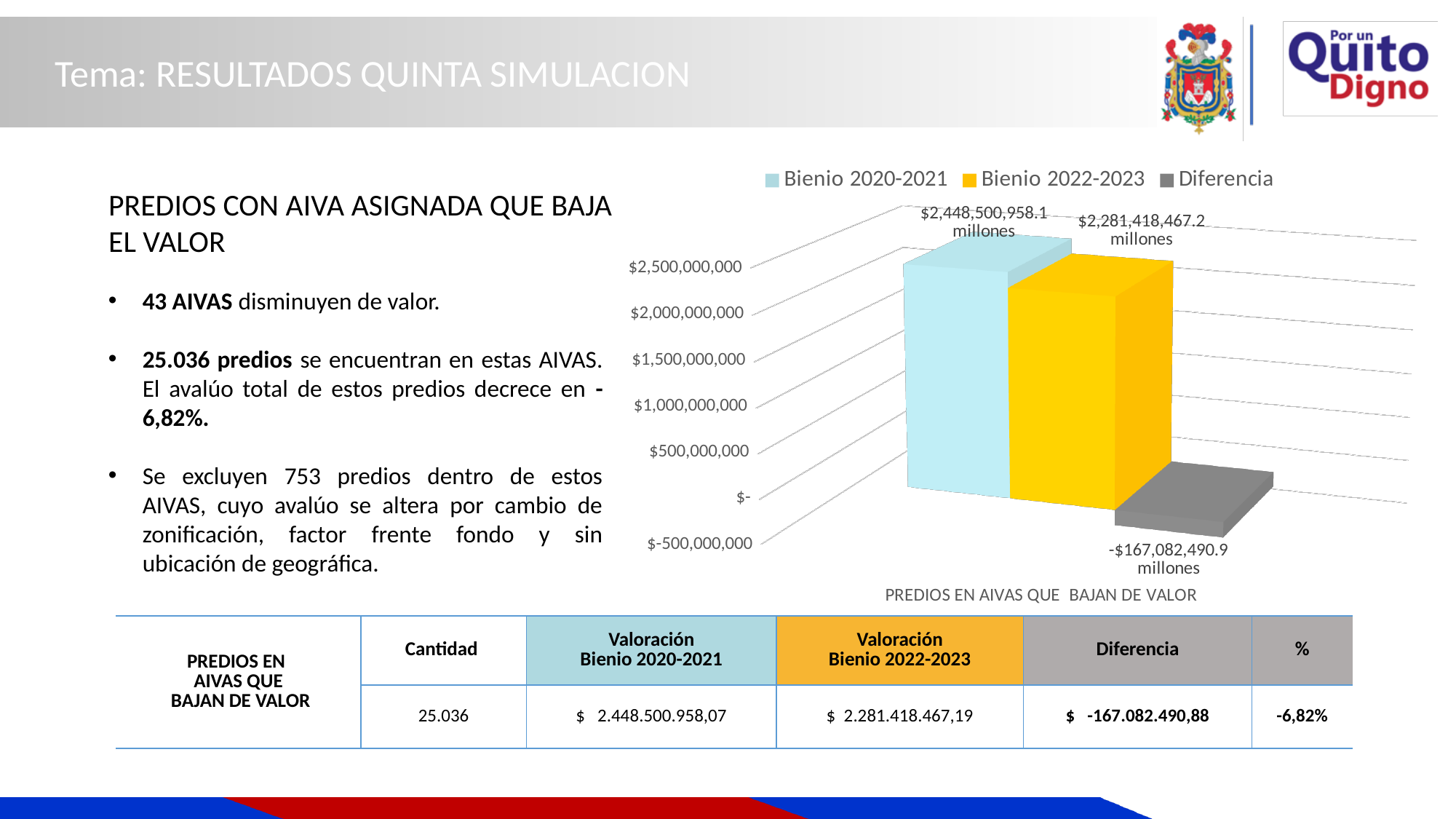
Which series has the highest value in the chart? Bienio 2020-2021 What is the value of the Bienio 2020-2021 bar in the chart? $2,448,500,958.1 millones Which series has the lowest value in the chart? Diferencia What is the value of the Diferencia bar in the chart? -$167,082,490.9 millones How many series does the chart legend list? 3 Is the value of the Bienio 2022-2023 bar greater or less than $2,500,000,000? less What is the value of the Bienio 2022-2023 bar in the chart? $2,281,418,467.2 millones Is the value of the Bienio 2020-2021 bar greater or less than $2,000,000,000? greater What is the category label shown below the chart? PREDIOS EN AIVAS QUE BAJAN DE VALOR What colour is the Bienio 2022-2023 series in the chart? Yellow Which is larger in the chart, the Bienio 2020-2021 value or the Bienio 2022-2023 value? Bienio 2020-2021 What kind of chart is shown on the slide? Bar chart